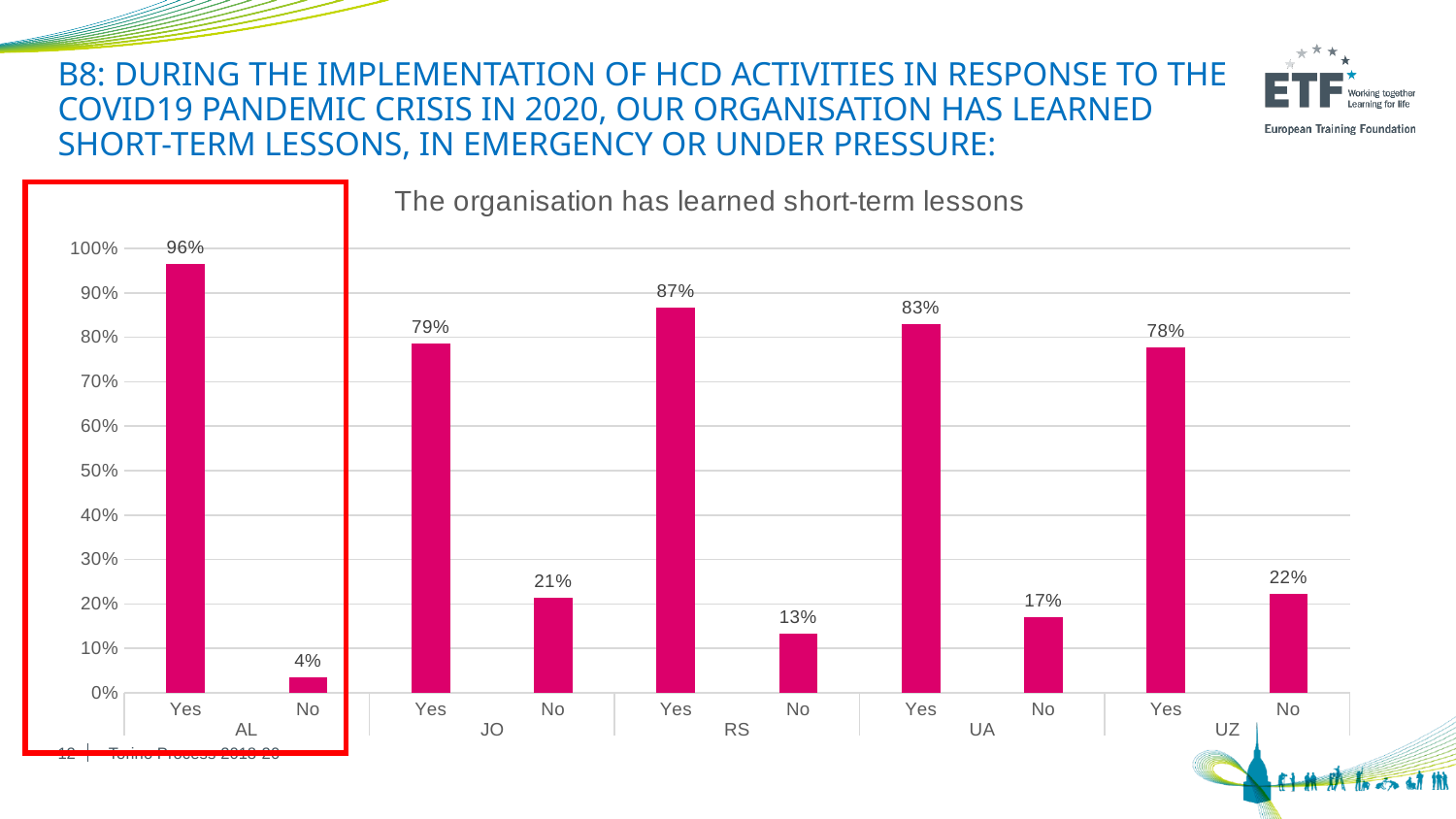
What kind of chart is shown on the slide? bar chart Which is larger, the "No" value for RS or the "No" value for UA? UA How many countries are shown on the x axis? 5 What is the value for "No" in UZ? 22% Which country has the lowest "No" value? AL Is the value for "Yes" in JO greater or less than 70%? greater Which country has the highest "Yes" value? AL What is the value for "Yes" in AL? 96% What is the value for "Yes" in RS? 87% What is the difference between the "Yes" values for UA and UZ? 5% What is the value for "No" in JO? 21% What is the title of the chart? The organisation has learned short-term lessons